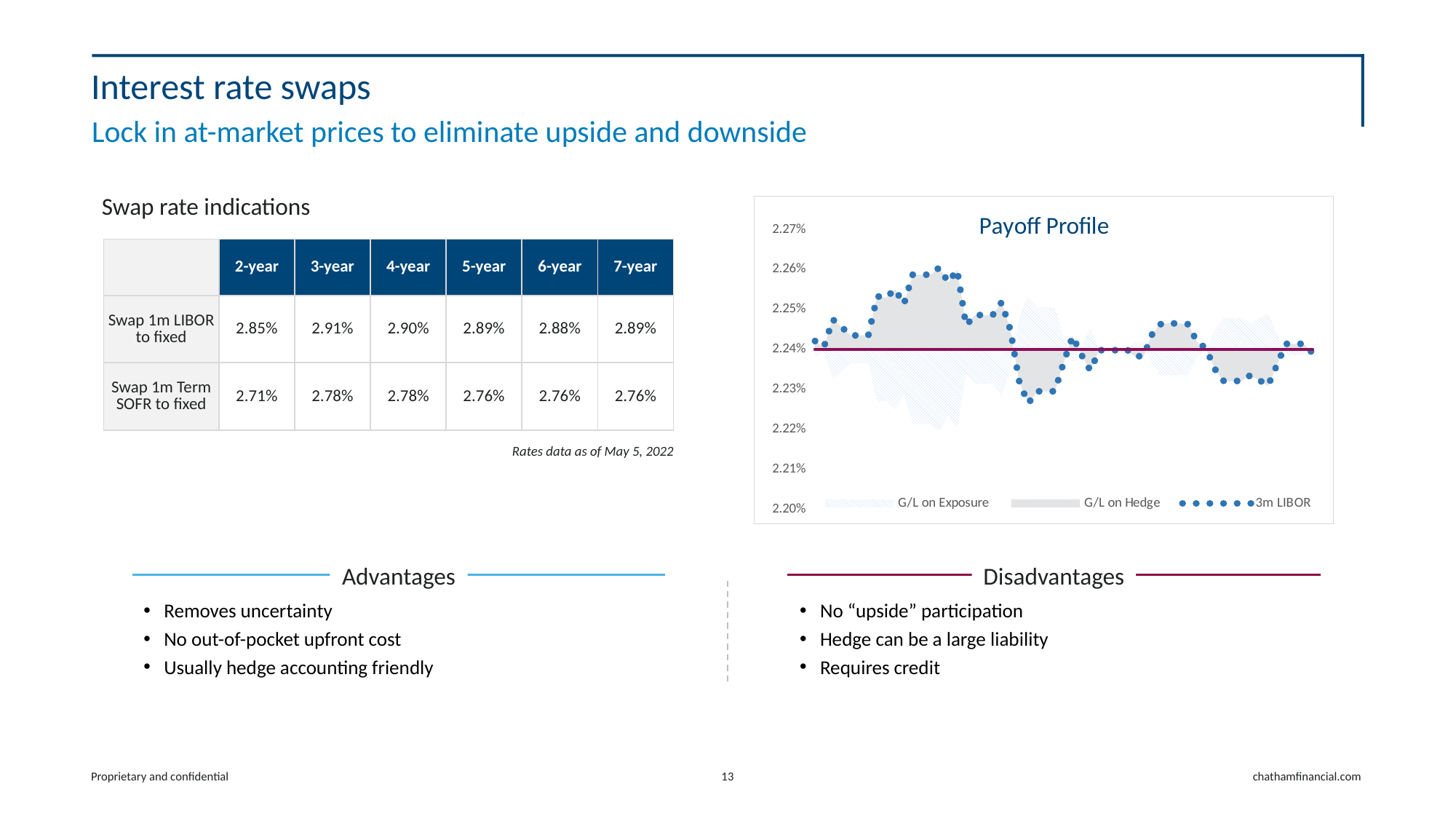
In the Payoff Profile chart, is the lowest value of the 3m LIBOR series greater or less than 2.22%? greater In the Payoff Profile chart, is the highest value of the 3m LIBOR series greater or less than 2.25%? greater What is the title of the chart on the slide? Payoff Profile In the Payoff Profile chart, is the highest value of the 3m LIBOR series greater or less than 2.27%? less How many series does the legend of the Payoff Profile chart list? 3 In the Payoff Profile chart, which series is drawn as a dotted line? 3m LIBOR